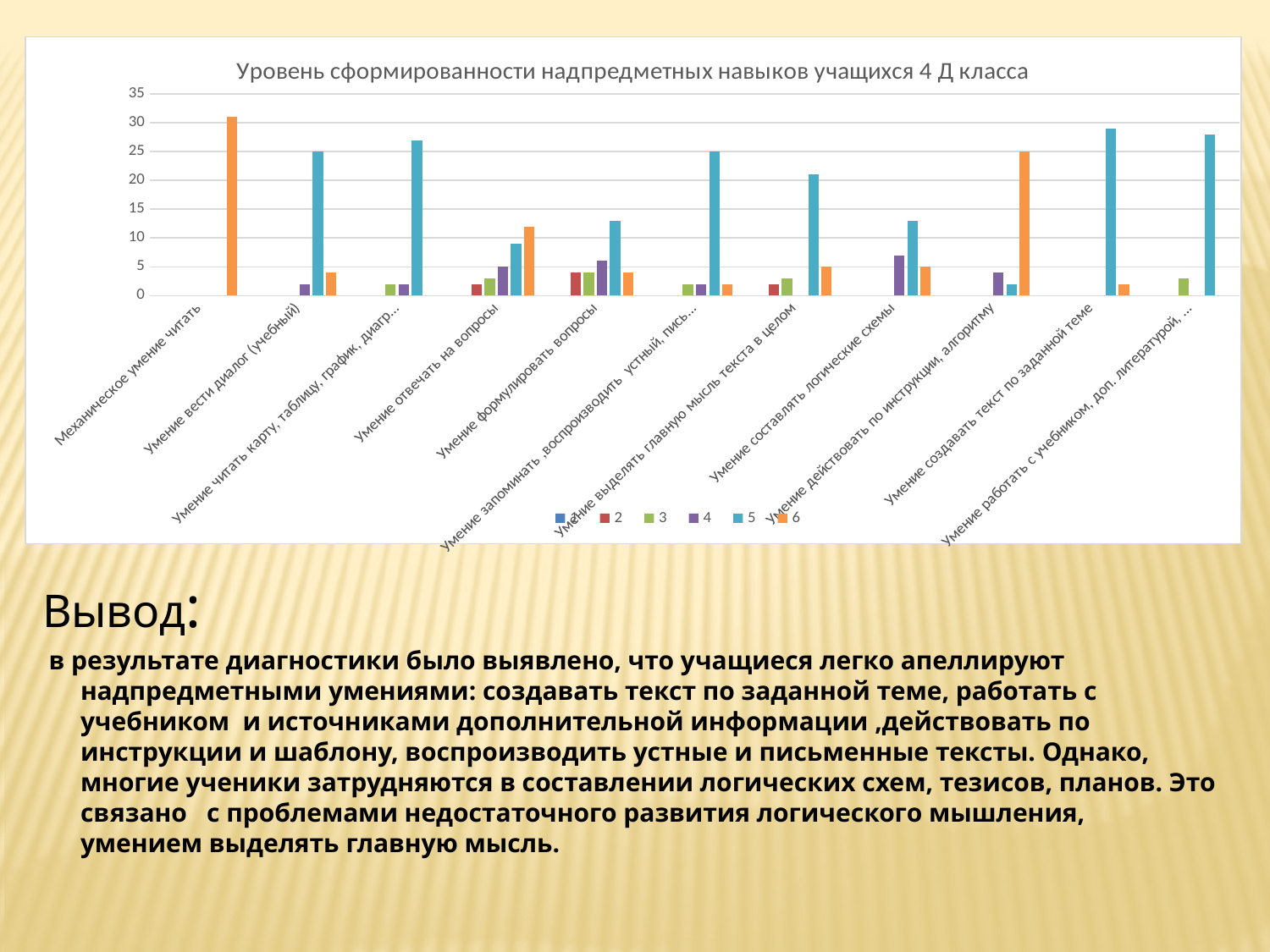
Is the value of series 6 for 'Умение отвечать на вопросы' greater or less than 10? greater How many categories are shown along the x axis? 11 What kind of chart is shown on the slide? bar chart What is the title of the chart? Уровень сформированности надпредметных навыков учащихся 4 Д класса Which category has the highest bar for series 6? Механическое умение читать Is the value of series 5 for 'Умение формулировать вопросы' greater or less than 15? less Which is larger: series 5 for 'Умение создавать текст по заданной теме' or series 5 for 'Умение формулировать вопросы'? Умение создавать текст по заданной теме How many series does the legend list? 6 Is the value of series 6 for 'Механическое умение читать' greater or less than 25? greater Which series has the highest bar for 'Умение создавать текст по заданной теме'? 5